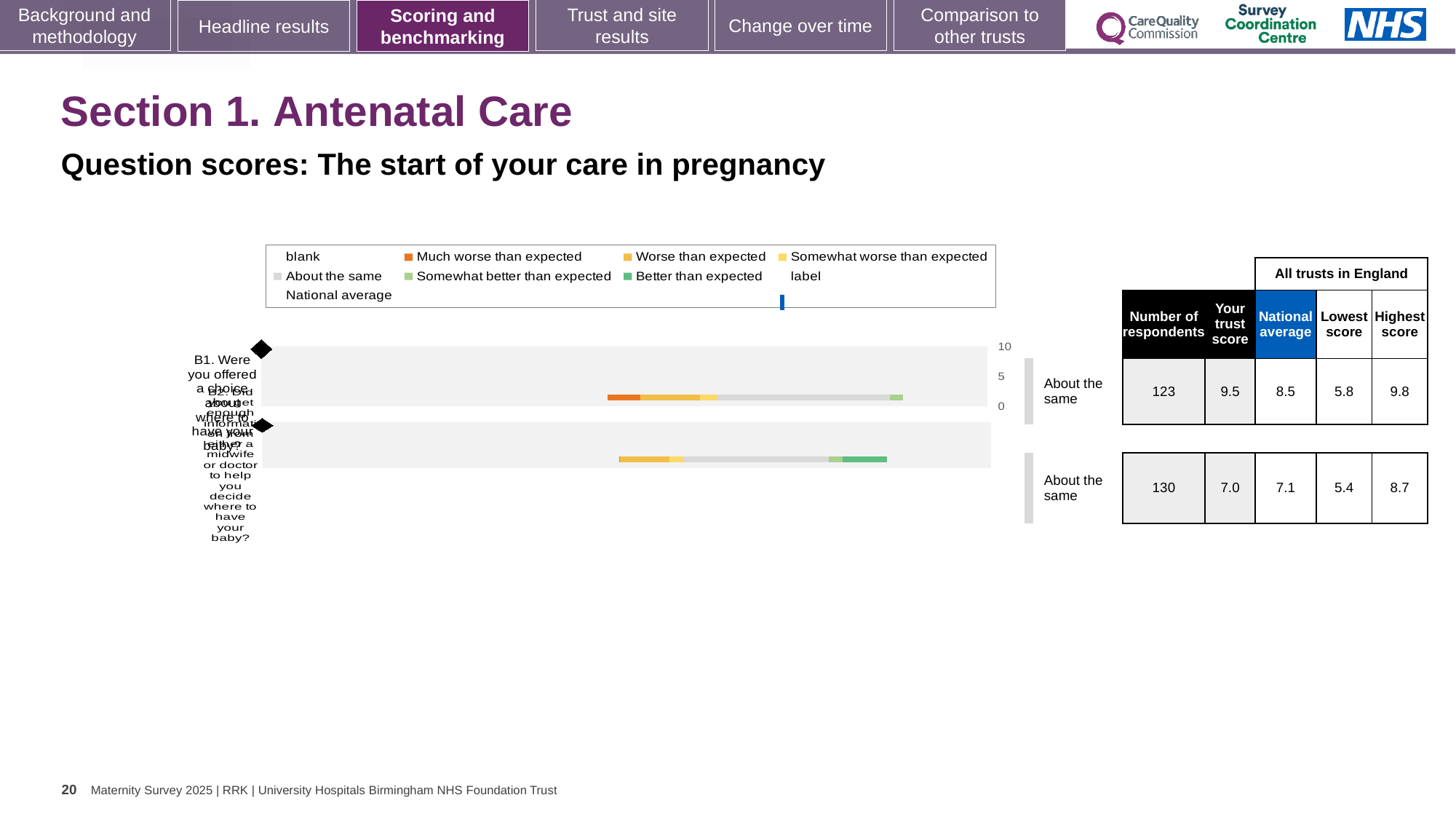
How many question bars are plotted in the chart? 2 In the table beside the chart, what is the highest score for the second question (B2)? 8.7 For the first question (B1), what is the difference between the highest score and the lowest score in the table? 4.0 In the chart legend, what colour represents 'Better than expected'? green What kind of chart is shown on the slide? bar chart For the first question (B1), is the trust score or the national average higher? trust score In the table beside the chart, how many respondents are listed for the second question (B2)? 130 In the table beside the chart, what is 'Your trust score' for the first question (B1)? 9.5 Which question has the higher 'Your trust score', B1 or B2? B1 In the table beside the chart, what is the national average for the first question (B1)? 8.5 In the chart legend, what colour represents 'Much worse than expected'? orange What benchmark label is shown next to each bar in the chart? About the same